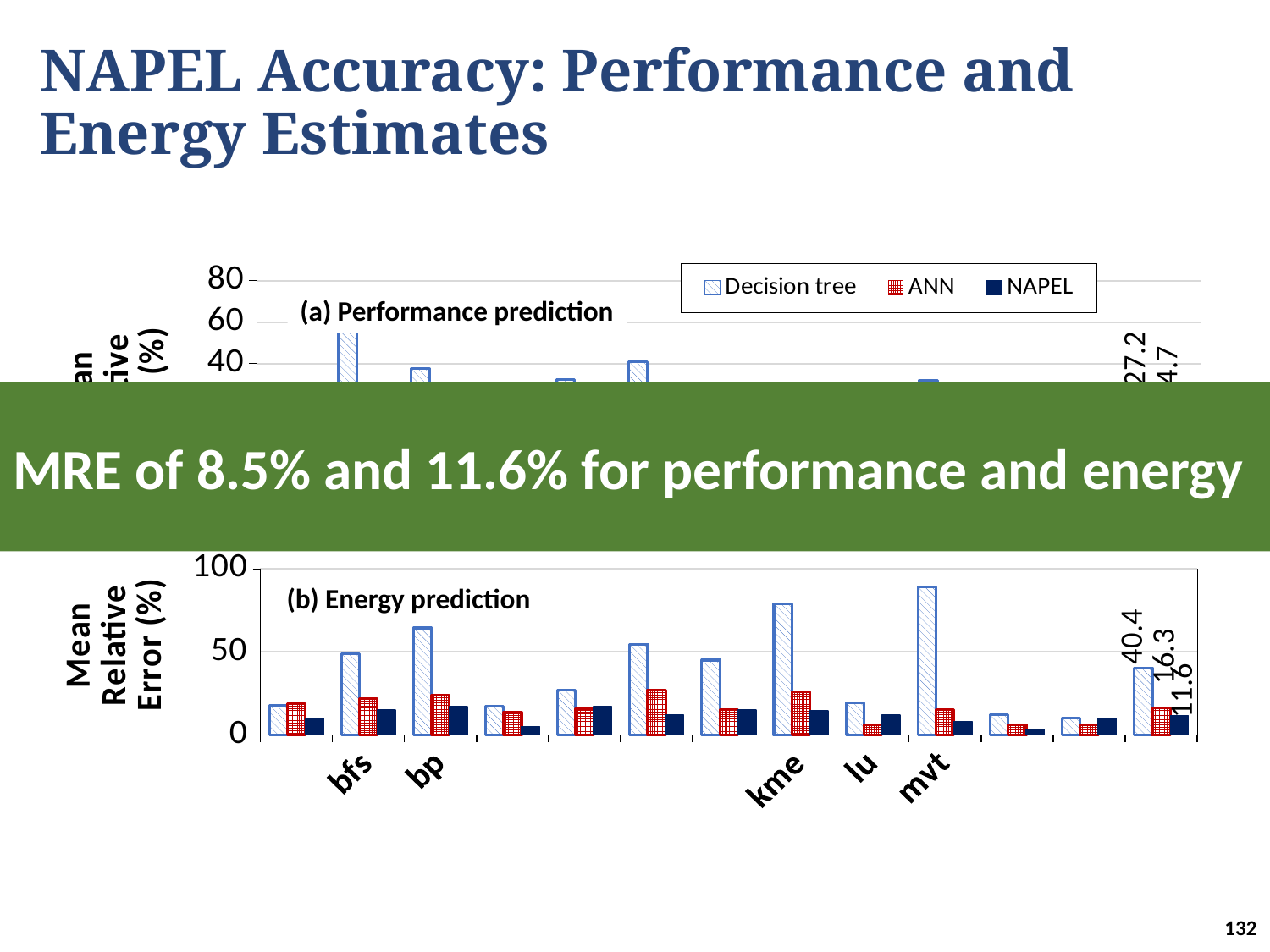
What is the highest value shown on the y axis of the '(b) Energy prediction' chart? 100 In the '(b) Energy prediction' chart, which is larger for kme: the Decision tree value or the NAPEL value? Decision tree In the '(b) Energy prediction' chart, which labeled category has the highest Decision tree bar? mvt How many series does the legend list? 3 What kind of chart is the '(b) Energy prediction' chart? bar chart In the '(b) Energy prediction' chart, is the Decision tree value for lu greater or less than 50? less In the '(b) Energy prediction' chart, what is the NAPEL value shown by the data label on the rightmost group of bars? 11.6 In the '(b) Energy prediction' chart, is the Decision tree value for mvt greater or less than 50? greater What are the three series named in the legend? Decision tree, ANN, NAPEL In the '(b) Energy prediction' chart, what is the ANN value shown by the data label on the rightmost group of bars? 16.3 In the '(b) Energy prediction' chart, what is the Decision tree value shown by the data label on the rightmost group of bars? 40.4 In the '(b) Energy prediction' chart, what is the difference between the Decision tree (40.4) and NAPEL (11.6) data labels on the rightmost group of bars? 28.8